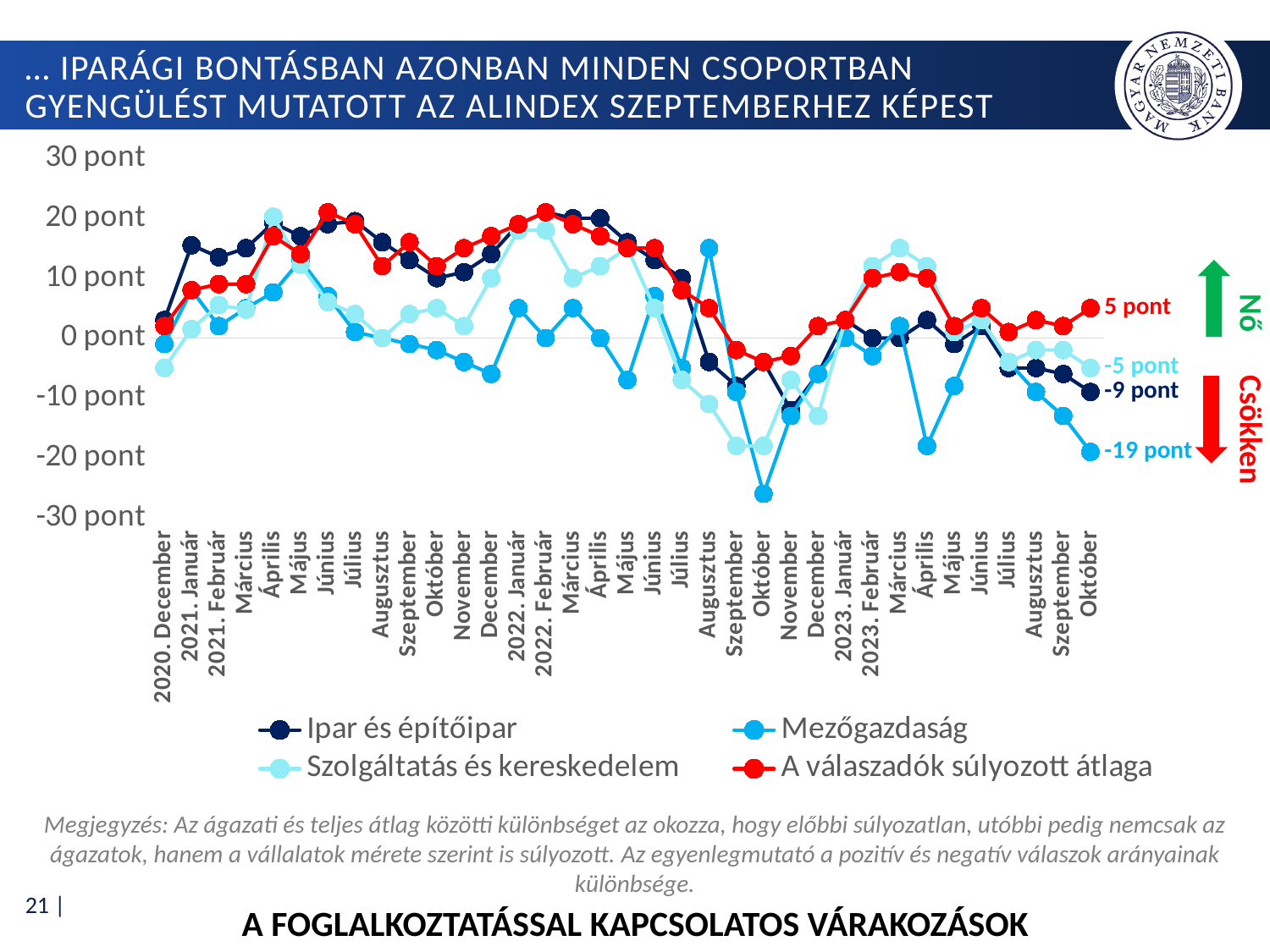
What colour is the line for A válaszadók súlyozott átlaga? red Is the value for Mezőgazdaság in 2022 Október greater or less than -20 pont? less What kind of chart is shown on the slide? line chart How many series does the legend list? 4 Which series has the highest value in 2023 Október? A válaszadók súlyozott átlaga Which series has the lowest value in 2023 Október? Mezőgazdaság What is the value for Szolgáltatás és kereskedelem in 2023 Október? -5 pont Does the Mezőgazdaság line rise or fall from 2023 Június to 2023 Október? fall What is the value for Mezőgazdaság in 2023 Október? -19 pont What is the value for Ipar és építőipar in 2023 Október? -9 pont What is the value for A válaszadók súlyozott átlaga in 2023 Október? 5 pont What is the difference between Ipar és építőipar and Mezőgazdaság in 2023 Október? 10 pont